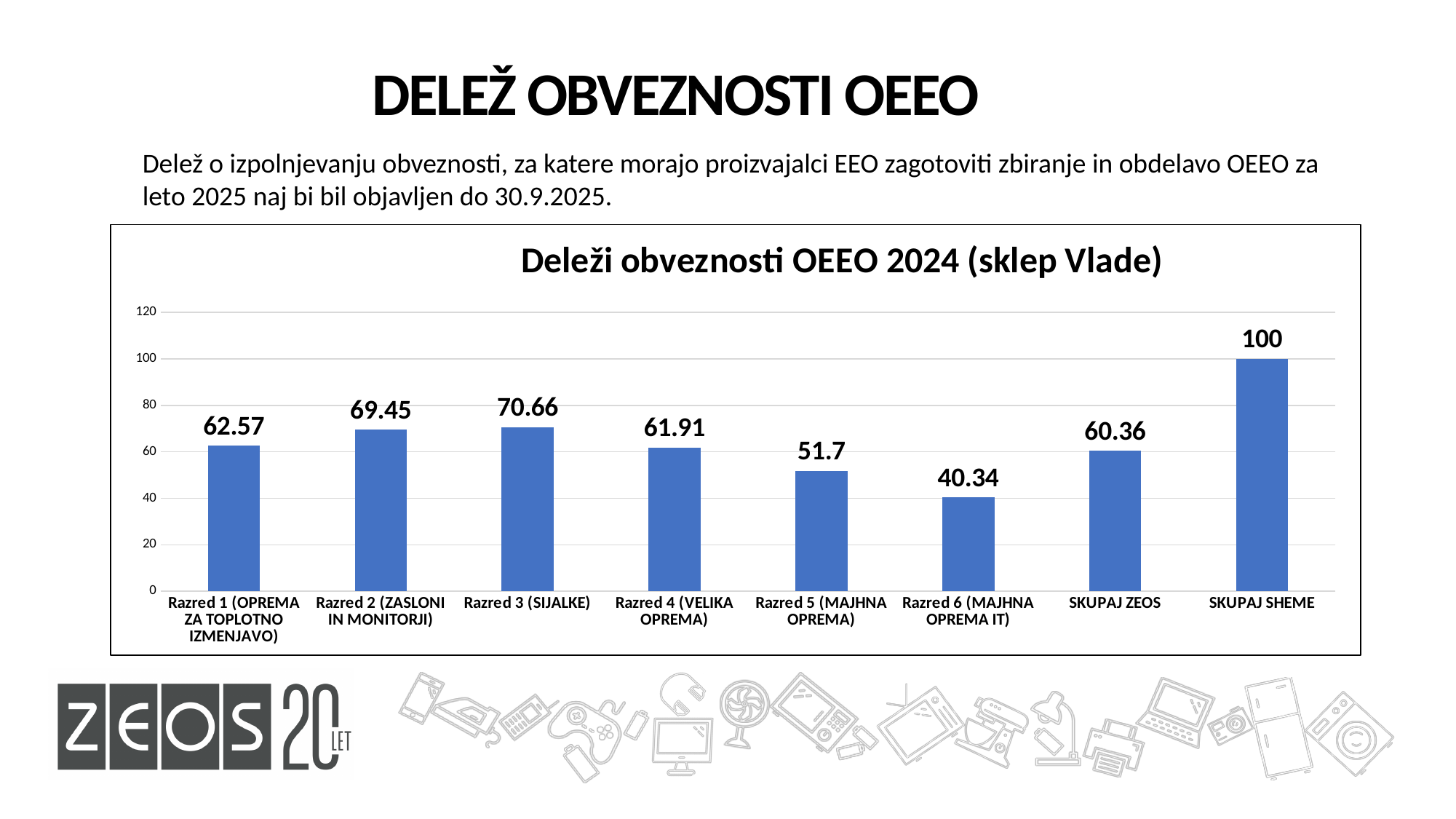
Is the value for Razred 5 (MAJHNA OPREMA) greater or less than 60? less What is the value for Razred 3 (SIJALKE)? 70.66 What is the value for Razred 6 (MAJHNA OPREMA IT)? 40.34 What kind of chart is shown on the slide? bar chart What is the value for SKUPAJ ZEOS? 60.36 What is the highest value shown on the y axis? 120 How many categories are shown on the x axis? 8 What is the difference between the values for Razred 2 (ZASLONI IN MONITORJI) and Razred 5 (MAJHNA OPREMA)? 17.75 Which is larger, the value for Razred 1 (OPREMA ZA TOPLOTNO IZMENJAVO) or Razred 4 (VELIKA OPREMA)? Razred 1 (OPREMA ZA TOPLOTNO IZMENJAVO) What is the title of the chart? Deleži obveznosti OEEO 2024 (sklep Vlade) Which category has the highest value? SKUPAJ SHEME Which category has the lowest value? Razred 6 (MAJHNA OPREMA IT)